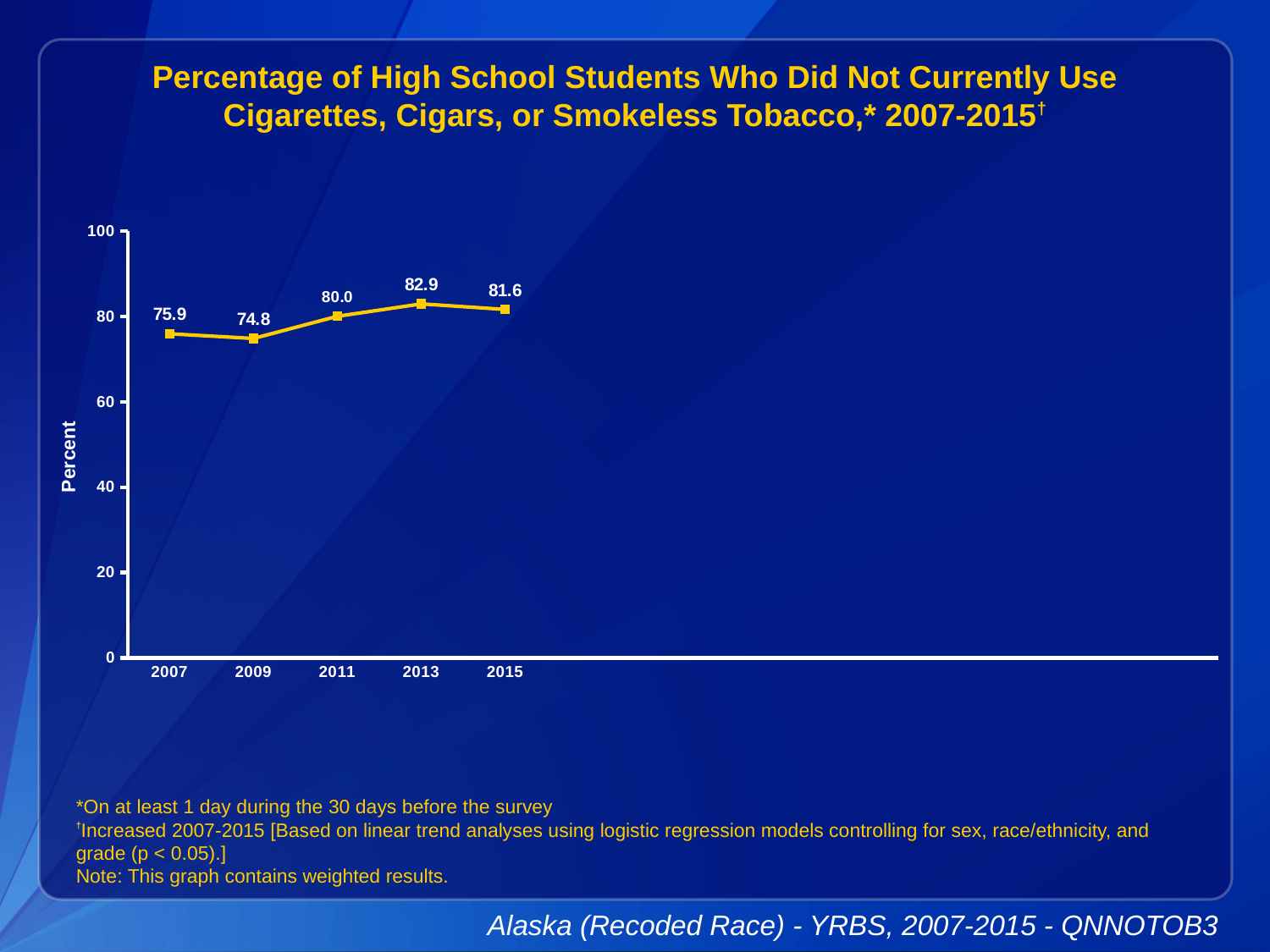
What kind of chart is shown on the slide? line chart What is the difference between the values for 2013 and 2007? 7.0 Which year has the highest value? 2013 Which year has the lowest value? 2009 How many data points are plotted on the chart? 5 Do the values generally rise or fall from 2007 to 2015? rise Which is larger, the value for 2011 or the value for 2009? 2011 Is the value for 2009 greater or less than 80? less What is the label on the y axis? Percent What is the value for 2013? 82.9 What is the value for 2007? 75.9 What is the value for 2015? 81.6